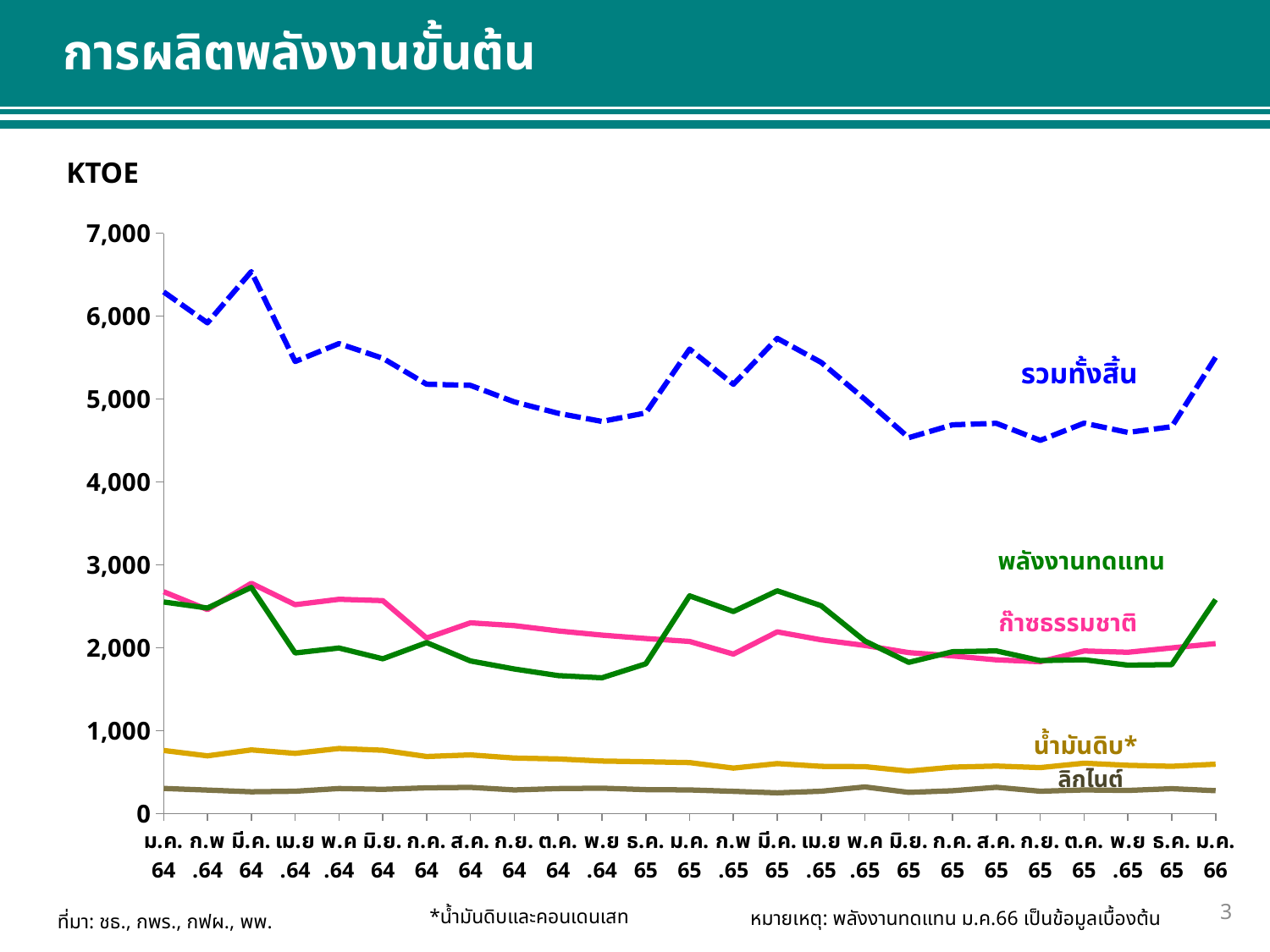
Which series has the lowest values throughout the chart? ลิกไนต์ What unit is shown for the y axis of the chart? KTOE How many data series are plotted on the chart? 5 What kind of chart is shown on the slide? line chart Which series has the highest values throughout the chart? รวมทั้งสิ้น Is the value of พลังงานทดแทน in พ.ย. 64 greater or less than 2,000? less How many monthly points are shown along the x axis? 25 In พ.ย. 64, which is larger: ก๊าซธรรมชาติ or พลังงานทดแทน? ก๊าซธรรมชาติ In ม.ค. 66, which is larger: พลังงานทดแทน or ก๊าซธรรมชาติ? พลังงานทดแทน In which month does the รวมทั้งสิ้น series reach its highest value? มี.ค. 64 Is the value of รวมทั้งสิ้น in ธ.ค. 65 greater or less than 5,000? less Is the value of รวมทั้งสิ้น in ม.ค. 64 greater or less than 6,000? greater